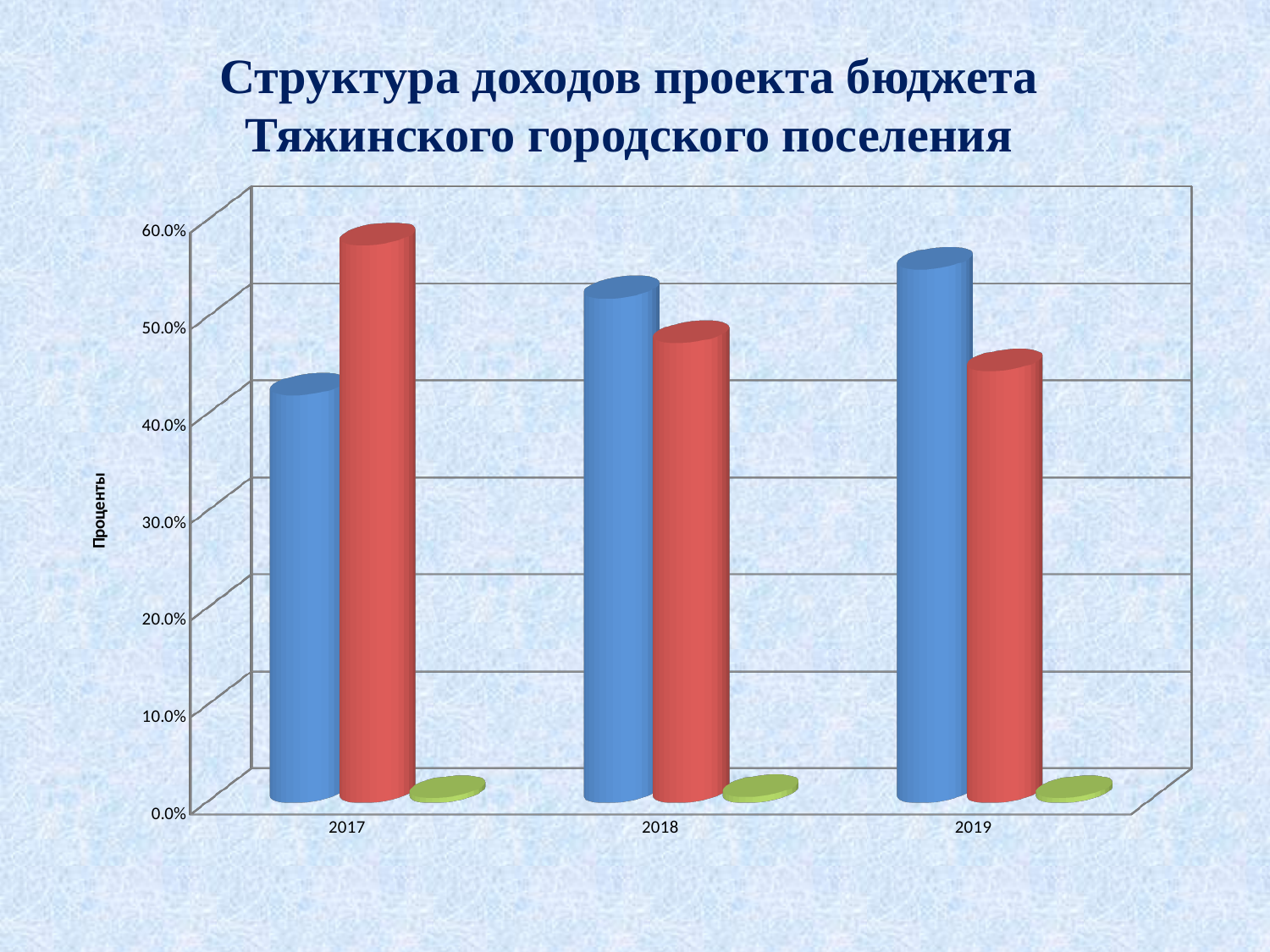
For 2019, which bar is taller, the blue one or the red one? the blue one Is the value of the blue bar for 2019 greater or less than 50%? greater Do the red bars rise or fall from 2017 to 2019? fall Is the value of the blue bar for 2017 greater or less than 40%? greater Is the value of the red bar for 2019 greater or less than 50%? less What kind of chart is shown on the slide? bar chart What is the label of the vertical axis of the chart? Проценты For 2017, which bar is taller, the blue one or the red one? the red one How many years are shown on the x axis of the chart? 3 What is the title of the slide's chart? Структура доходов проекта бюджета Тяжинского городского поселения In which year is the blue bar the tallest? 2019